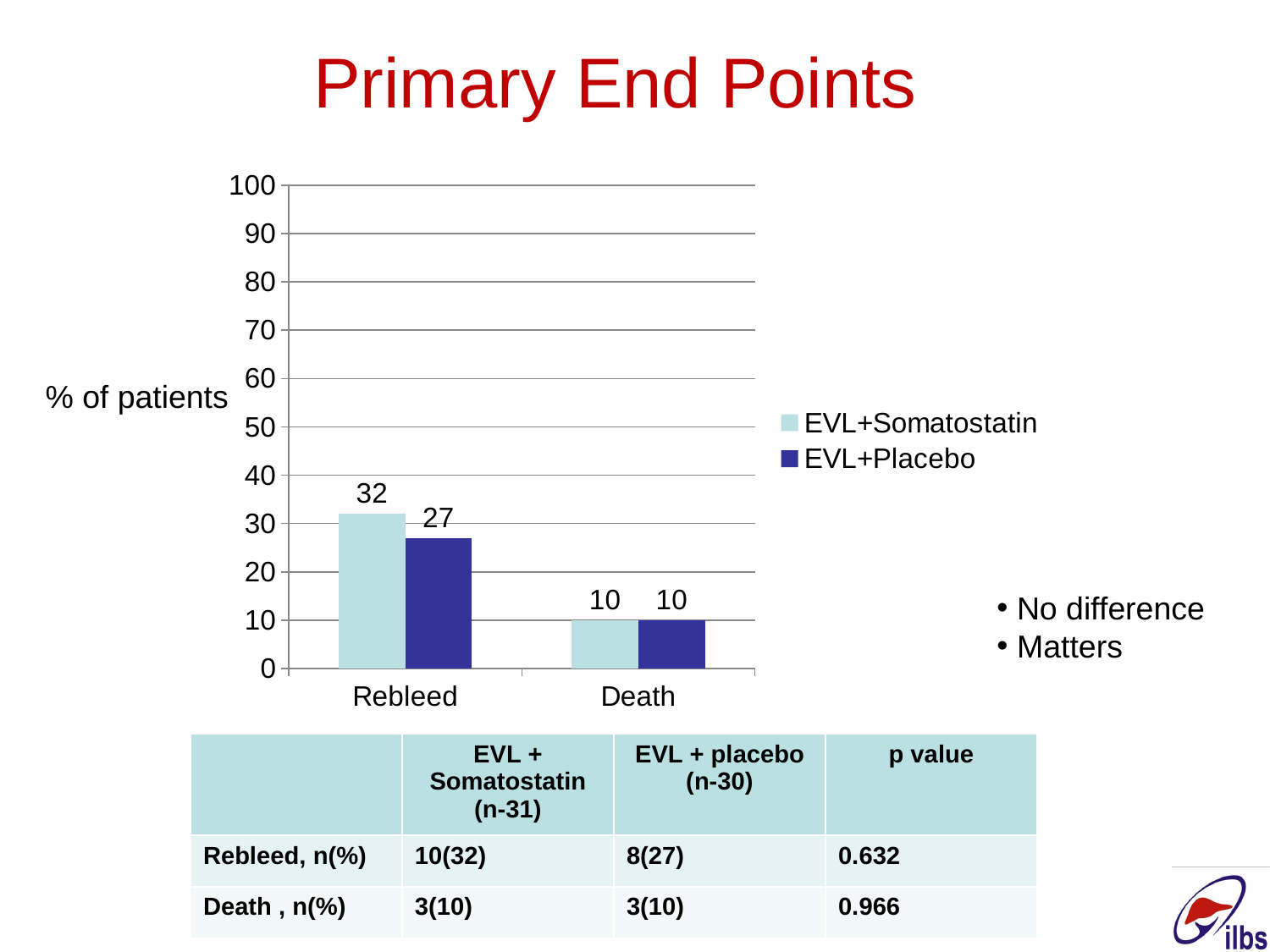
What is the value for EVL+Placebo in the Death category? 10 What is the label of the y axis? % of patients What kind of chart is shown on the slide? Bar chart What is the difference between the EVL+Somatostatin and EVL+Placebo values for Rebleed? 5 What is the value for EVL+Somatostatin in the Rebleed category? 32 Which category has the highest value for EVL+Somatostatin? Rebleed Which category has the lowest value for EVL+Placebo? Death What is the value for EVL+Placebo in the Rebleed category? 27 How many categories are shown on the x axis? 2 For Rebleed, which series has the larger value, EVL+Somatostatin or EVL+Placebo? EVL+Somatostatin How many series does the legend list? 2 What is the value for EVL+Somatostatin in the Death category? 10